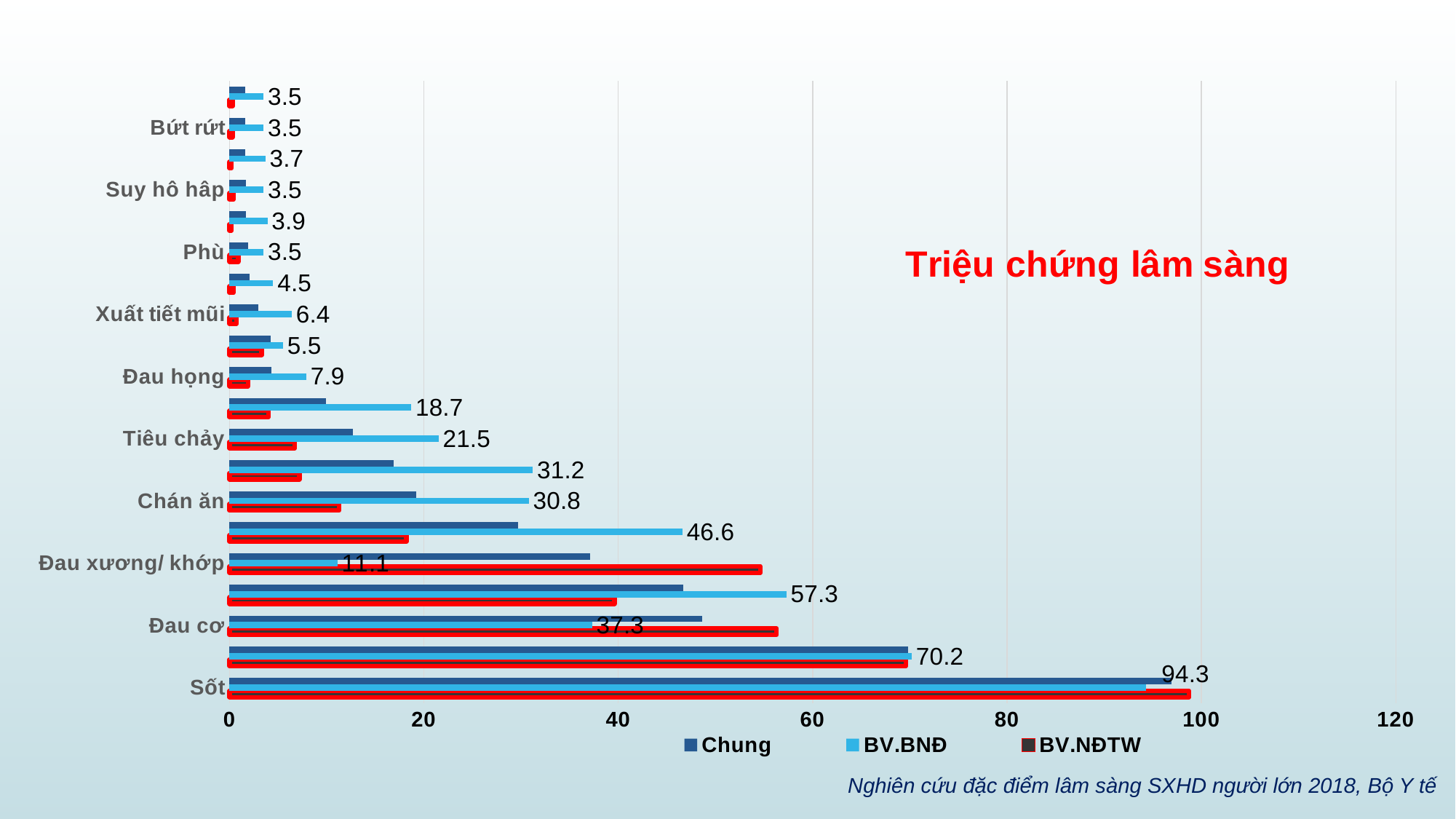
How many series does the legend list? 3 What is the BV.BNĐ value for Sốt? 94.3 What is the BV.BNĐ value for Đau họng? 7.9 Which labeled category has the highest BV.BNĐ value? Sốt What is the title of the chart? Triệu chứng lâm sàng What kind of chart is shown on the slide? bar chart What is the BV.BNĐ value for Tiêu chảy? 21.5 What is the difference between the BV.BNĐ values for Chán ăn and Tiêu chảy? 9.3 Is the BV.NĐTW value for Sốt greater or less than 80? greater What is the BV.BNĐ value for Chán ăn? 30.8 What is the BV.BNĐ value for Đau cơ? 37.3 For Đau xương/ khớp, which is larger: the BV.NĐTW value or the BV.BNĐ value? BV.NĐTW